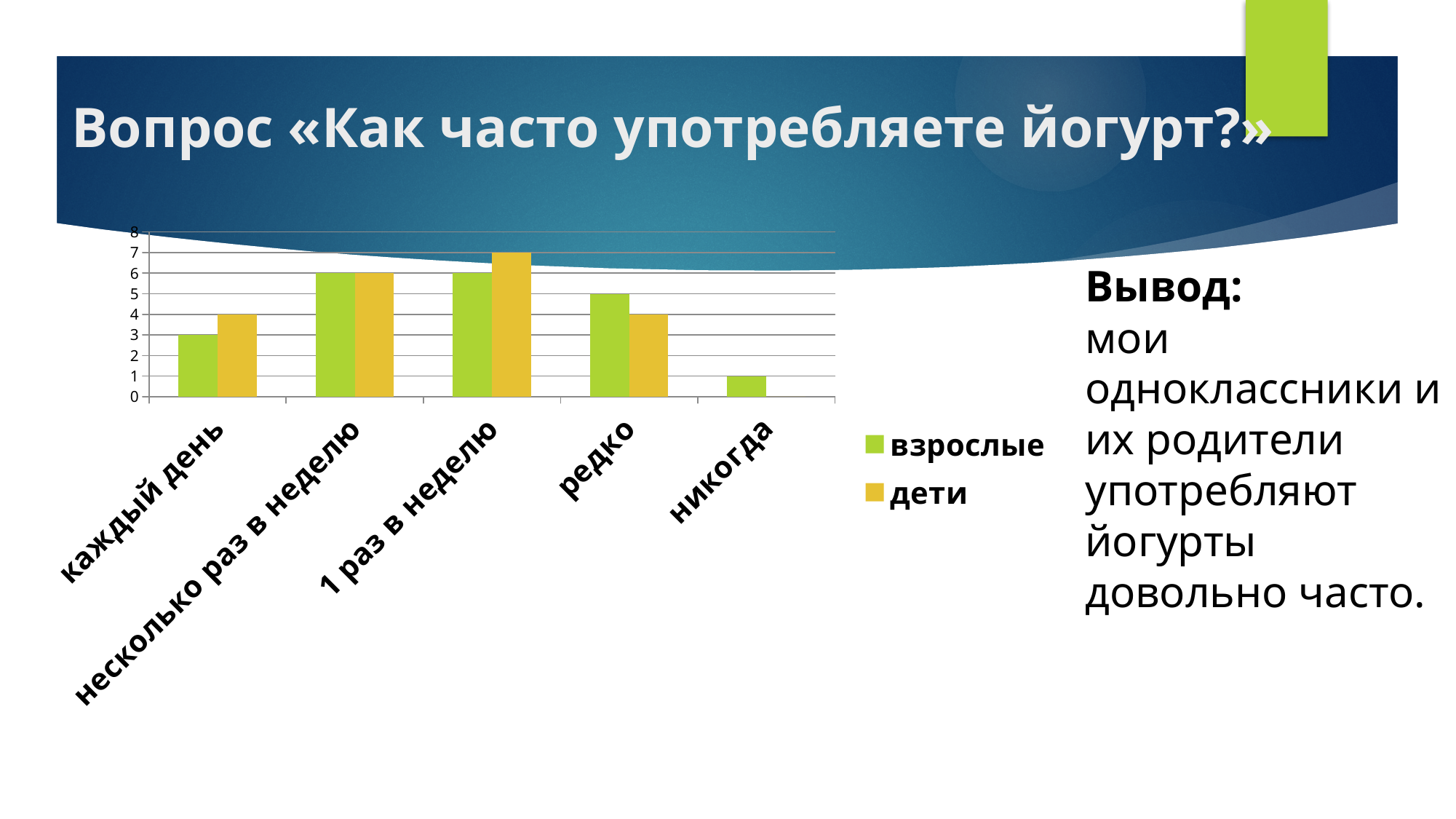
Which series is shown in green? взрослые What is the difference between дети and взрослые in the category каждый день? 1 Which category has the highest value for дети? 1 раз в неделю Is the value for взрослые in the category несколько раз в неделю greater or less than 4? greater What is the value for взрослые in the category каждый день? 3 What is the value for взрослые in the category редко? 5 In the category редко, which series has the larger value, взрослые or дети? взрослые What is the value for дети in the category 1 раз в неделю? 7 What kind of chart is shown on the slide? bar chart Which category has the lowest value for взрослые? никогда How many categories are shown on the x axis? 5 How many series does the legend list? 2